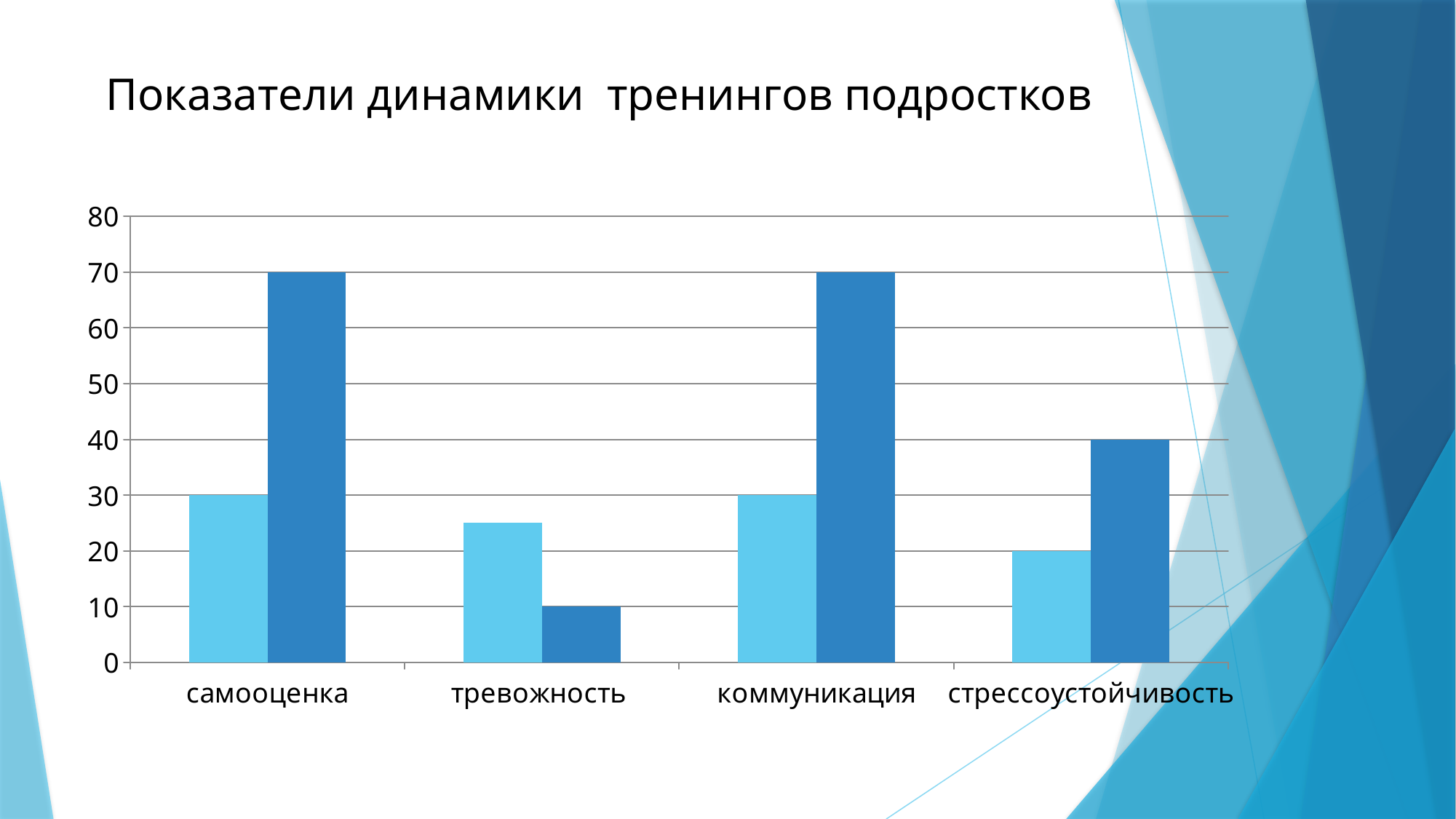
What is the value of the dark blue bar for самооценка? 70 What is the value of the light blue bar for самооценка? 30 What is the difference between the dark blue and light blue bars for самооценка? 40 What is the value of the dark blue bar for стрессоустойчивость? 40 What is the value of the light blue bar for стрессоустойчивость? 20 Which category has the lowest dark blue bar? тревожность What is the title of the chart slide? Показатели динамики тренингов подростков What type of chart is shown on the slide? bar chart For стрессоустойчивость, which bar is larger, the light blue or the dark blue? dark blue How many categories are shown on the x axis of the chart? 4 Is the value of the light blue bar for тревожность greater or less than 30? less What is the value of the dark blue bar for тревожность? 10